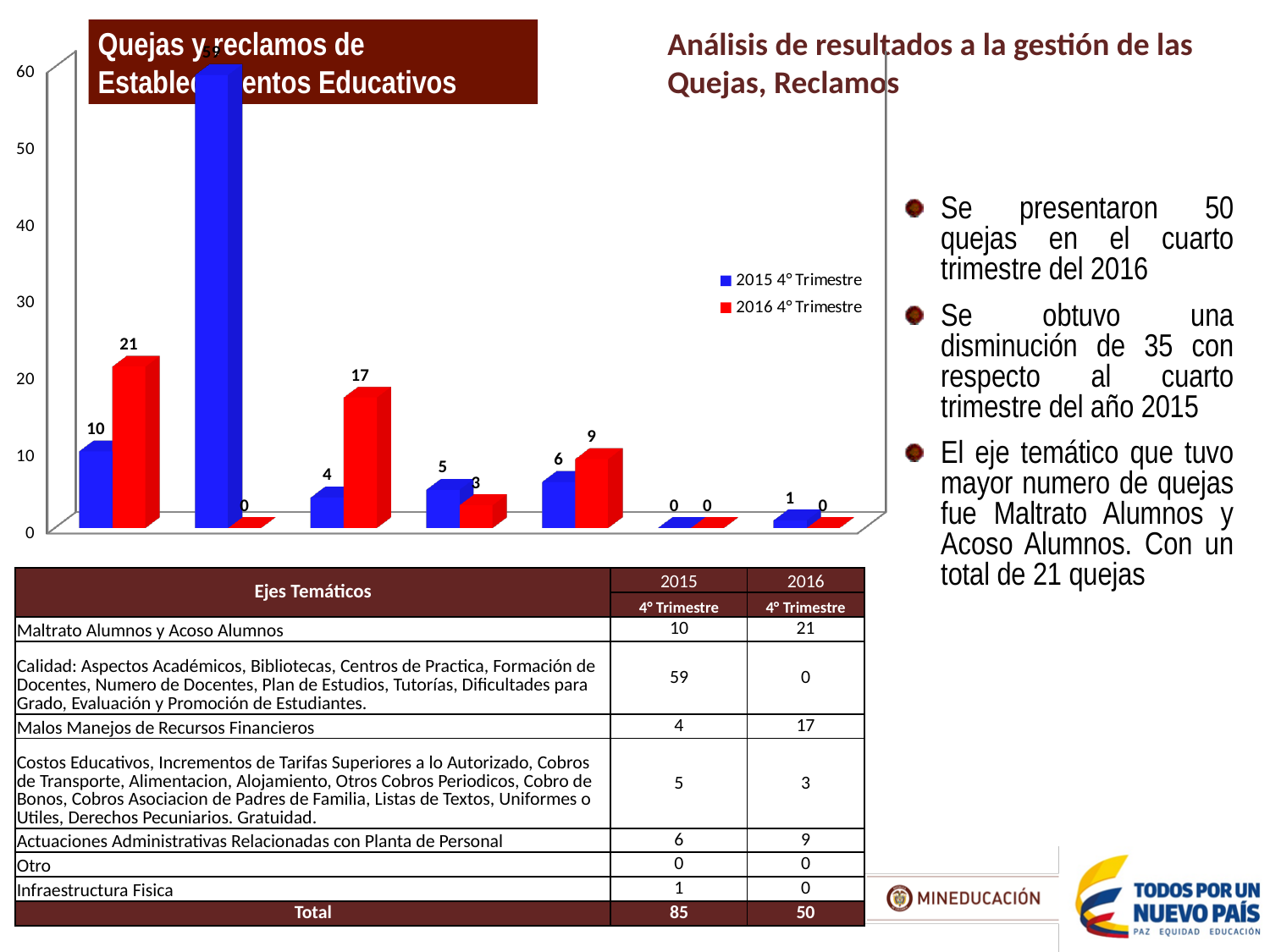
How many categories (Ejes Temáticos) are plotted in the chart? 7 What kind of chart is shown on the slide? Bar chart What is the 2016 4° Trimestre value for Maltrato Alumnos y Acoso Alumnos? 21 What is the 2015 4° Trimestre value for Malos Manejos de Recursos Financieros? 4 By how much does the 2016 4° Trimestre value for Malos Manejos de Recursos Financieros exceed the 2015 4° Trimestre value? 13 What are the two series named in the chart legend? 2015 4° Trimestre and 2016 4° Trimestre Which category has the highest bar in the 2015 4° Trimestre series? Calidad: Aspectos Académicos, Bibliotecas, Centros de Practica, Formación de Docentes, Numero de Docentes, Plan de Estudios, Tutorías, Dificultades para Grado, Evaluación y Promoción de Estudiantes. Which category has the highest bar in the 2016 4° Trimestre series? Maltrato Alumnos y Acoso Alumnos For Actuaciones Administrativas Relacionadas con Planta de Personal, which series has the larger value, 2015 4° Trimestre or 2016 4° Trimestre? 2016 4° Trimestre What colour are the bars for the 2016 4° Trimestre series? Red How many series does the chart legend list? 2 What is the 2016 4° Trimestre value for Infraestructura Fisica? 0